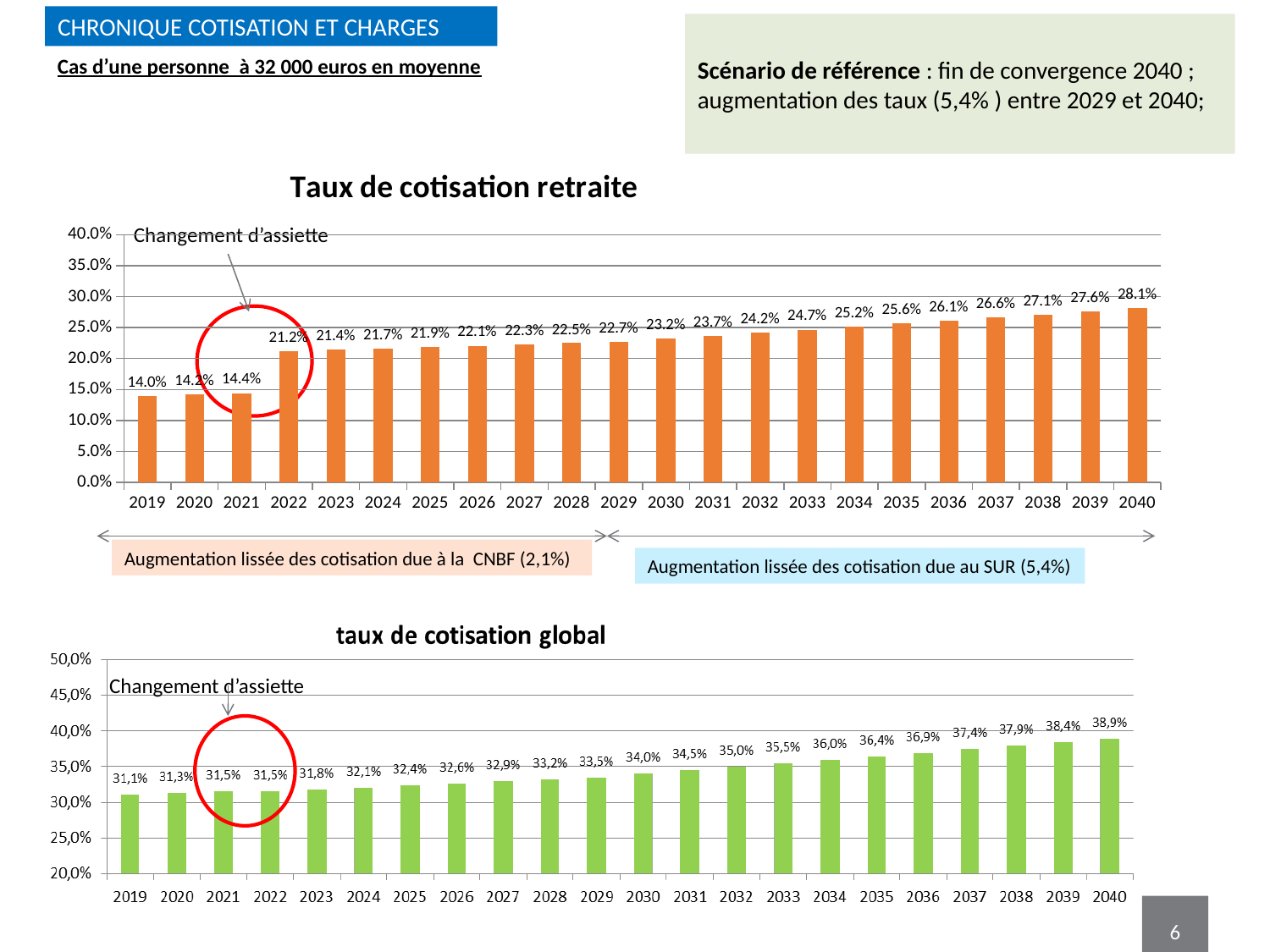
In the 'taux de cotisation global' chart, which is larger, the value for 2030 or the value for 2025? 2030 In the 'taux de cotisation global' chart, what is the difference between the values for 2040 and 2019? 7,8% In the 'Taux de cotisation retraite' chart, which year has the lowest value? 2019 In the 'taux de cotisation global' chart, what is the value for 2019? 31,1% What type of chart is the 'taux de cotisation global' chart? bar chart In the 'taux de cotisation global' chart, what is the value for 2033? 35,5% In the 'taux de cotisation global' chart, which year has the highest value? 2040 In the 'Taux de cotisation retraite' chart, how many years are plotted? 22 In the 'Taux de cotisation retraite' chart, what is the value for 2040? 28.1% In the 'Taux de cotisation retraite' chart, what is the difference between the values for 2022 and 2021? 6.8% In the 'Taux de cotisation retraite' chart, what is the value for 2022? 21.2% In the 'Taux de cotisation retraite' chart, do the values rise or fall from 2019 to 2040? rise